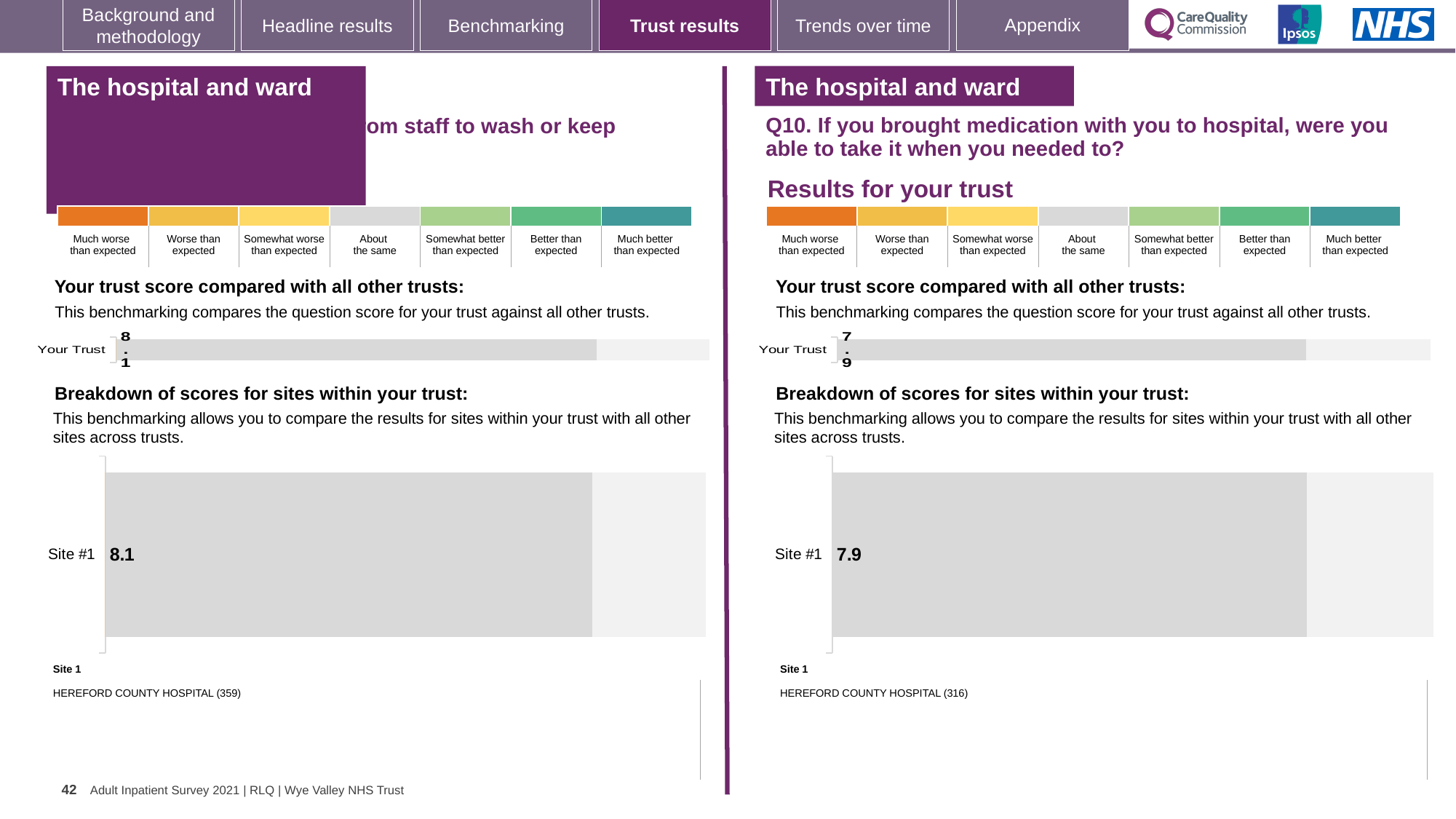
On the left-hand panel, what score is shown for Site #1 in the breakdown of scores for sites? 8.1 On the right-hand panel (Q10), what is the score shown for Your Trust? 7.9 On the right-hand panel (Q10), what score is shown for Site #1 in the breakdown of scores for sites? 7.9 On the left-hand panel, what is the score shown for Your Trust? 8.1 How many rating categories are shown in the colour scale above the charts on the right-hand panel? 7 What kind of chart is used to show the Site #1 score on the left-hand panel? Bar chart On the right-hand panel (Q10), which hospital is listed as Site 1? HEREFORD COUNTY HOSPITAL (316) What is the difference between the Site #1 score on the left-hand panel and the Site #1 score on the right-hand panel (Q10)? 0.2 On the right-hand panel (Q10), is the Site #1 score greater or less than 7? greater Which panel shows the higher trust score, the left-hand panel or the right-hand panel (Q10)? Left-hand panel How many sites are shown in the breakdown of scores chart on the right-hand panel (Q10)? 1